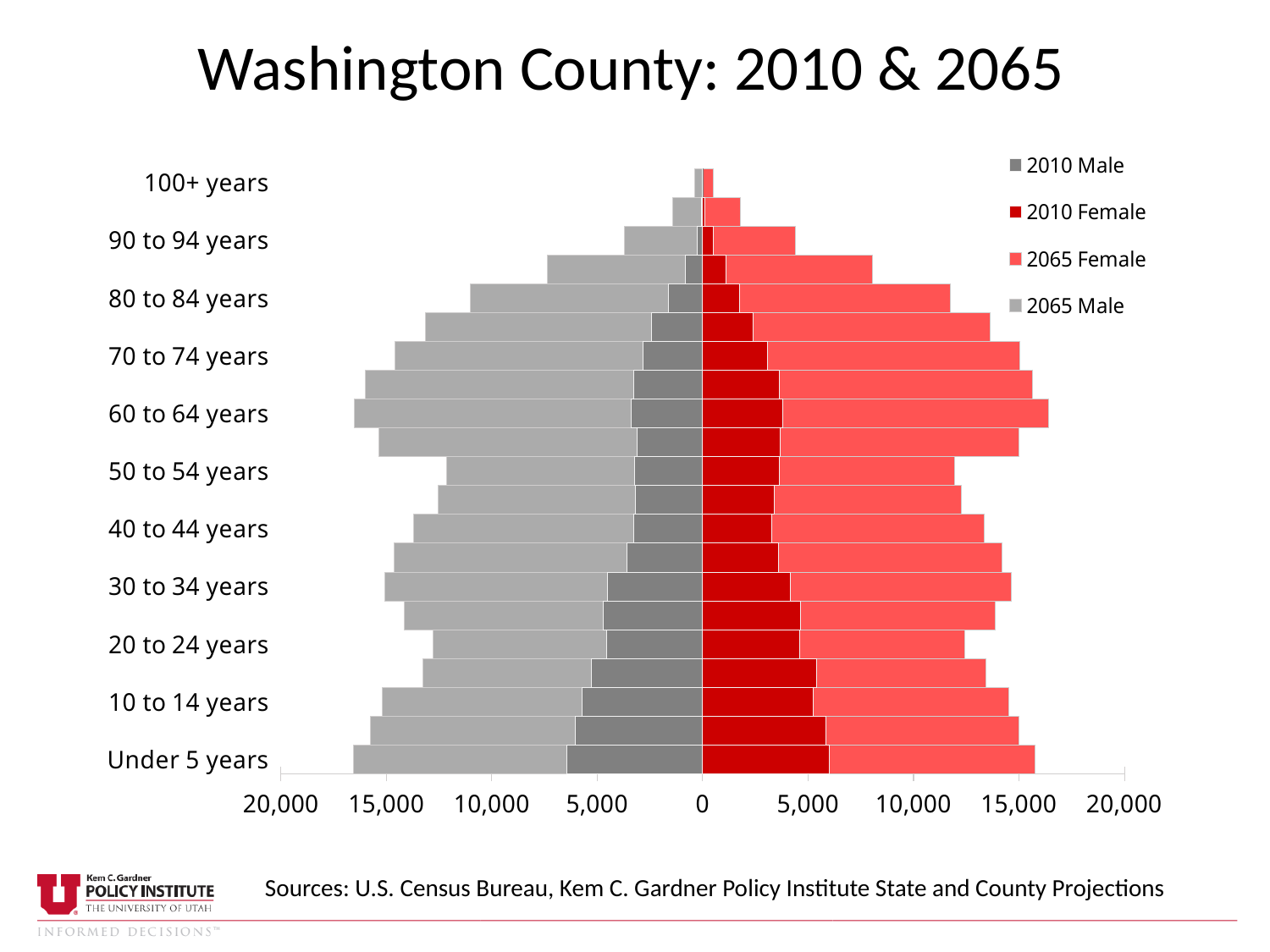
Which age group has the smallest 2065 Female value? 100+ years Which series is shown in light grey? 2065 Male Is the 2065 Male value for 60 to 64 years greater or less than 15,000? greater What is the title of the chart? Washington County: 2010 & 2065 Is the 2065 Male value for 80 to 84 years greater or less than 10,000? greater Is the 2010 Female value for Under 5 years greater or less than 5,000? greater For 60 to 64 years, which is larger: the 2065 Male value or the 2010 Male value? 2065 Male For 2010 Female, which is larger: the value for Under 5 years or the value for 80 to 84 years? Under 5 years How many series does the legend list? 4 What kind of chart is shown on the slide? bar chart